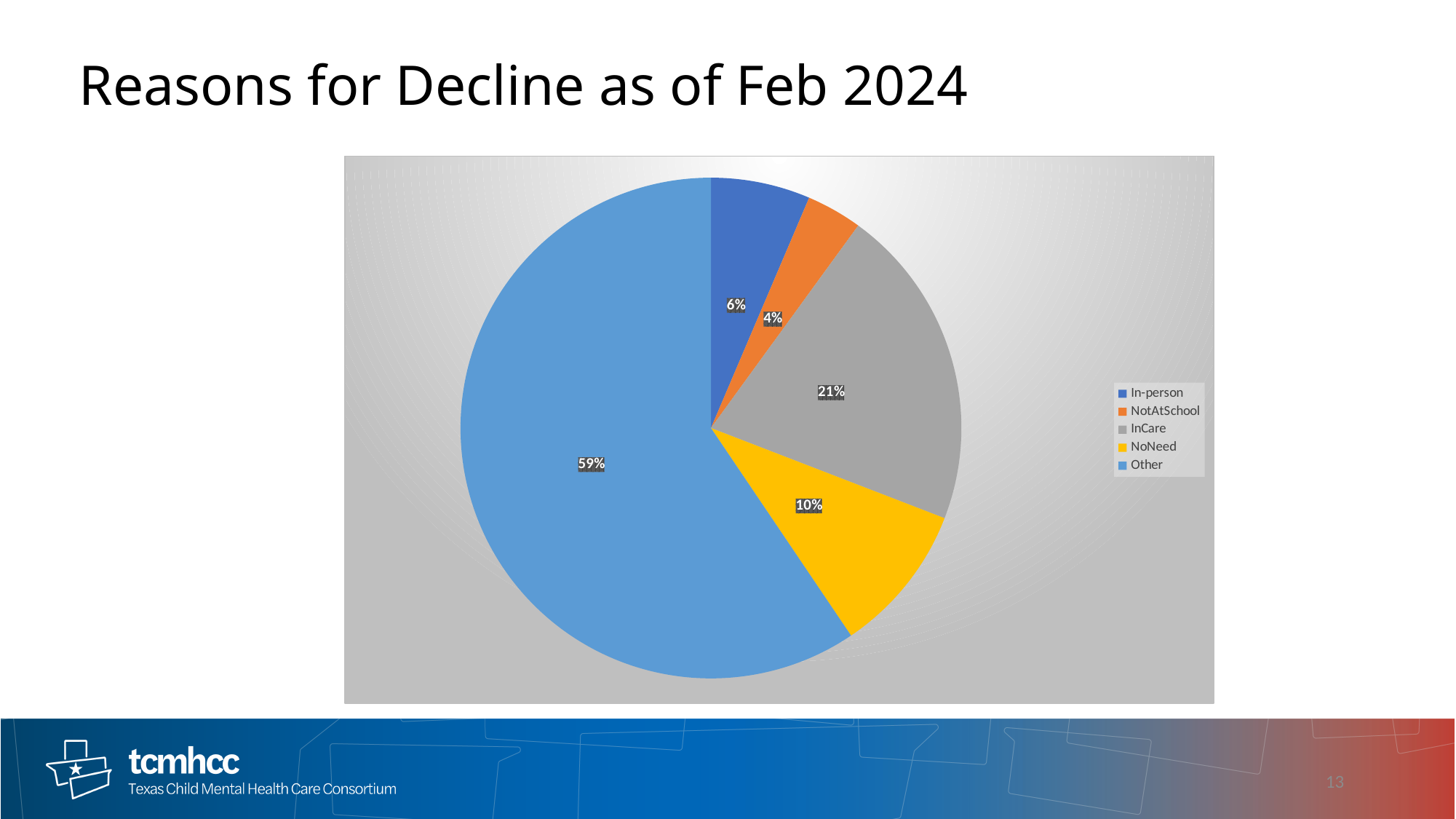
What is the difference between the InCare and NoNeed percentages? 11% What is the value shown for NoNeed? 10% What is the title of the slide containing the chart? Reasons for Decline as of Feb 2024 What share of the pie does the Other slice represent? 59% What type of chart is shown on the slide? pie chart Which category has the smallest slice of the pie? NotAtSchool What is the value shown for InCare? 21% How many categories does the pie chart have? 5 Which is larger, the In-person slice or the NotAtSchool slice? In-person What is the value shown for NotAtSchool? 4% What is the value shown for In-person? 6% Which category has the largest slice of the pie? Other